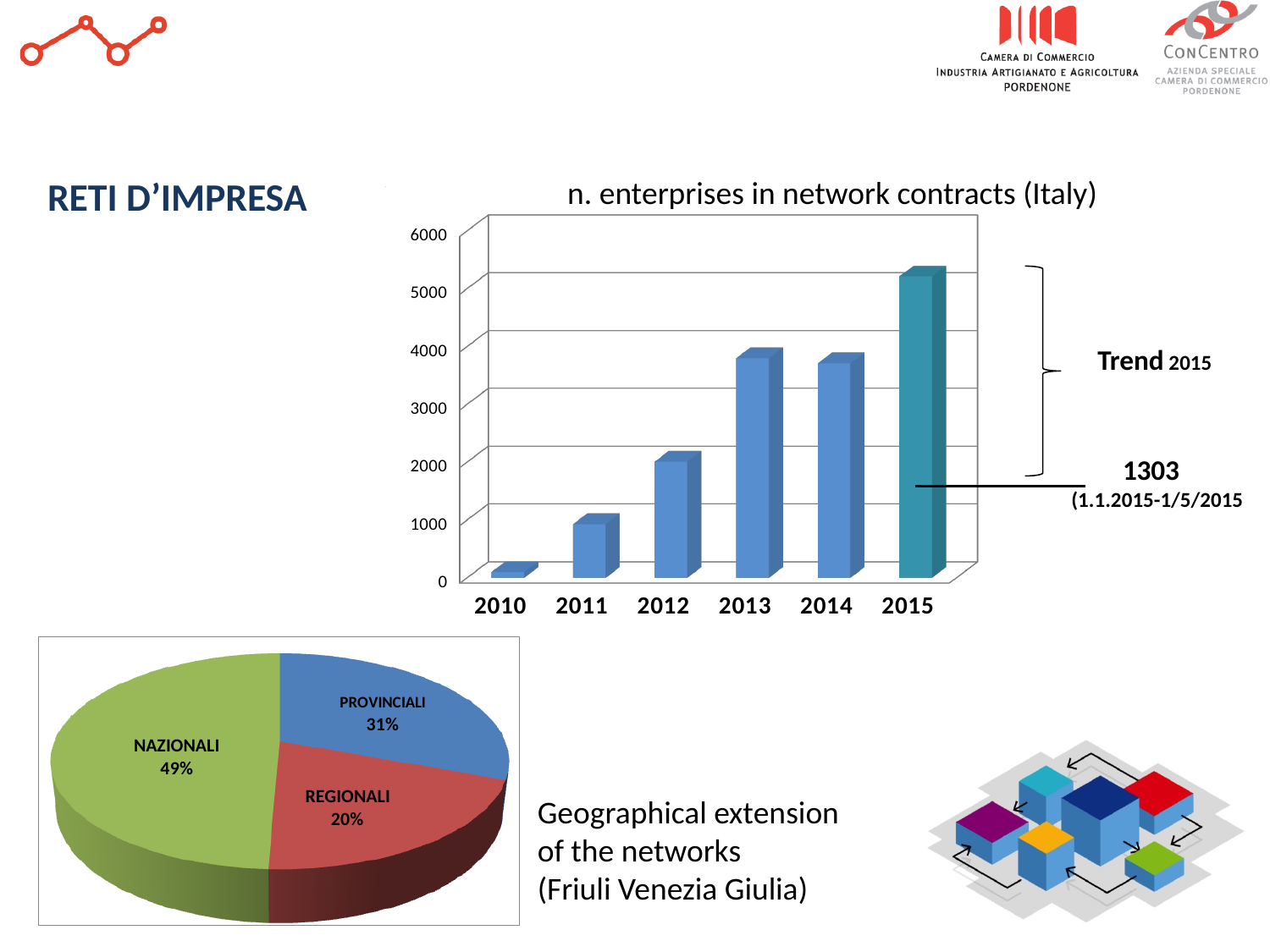
In the chart titled 'n. enterprises in network contracts (Italy)', what kind of chart is used? bar chart In the chart titled 'n. enterprises in network contracts (Italy)', is the value for 2010 greater or less than 1000? less In the pie chart at the bottom left, what share is NAZIONALI? 49% In the pie chart at the bottom left, what is the difference between the PROVINCIALI and REGIONALI shares? 11% In the chart titled 'n. enterprises in network contracts (Italy)', how many years are shown on the x axis? 6 In the chart titled 'n. enterprises in network contracts (Italy)', is the value for 2015 greater or less than 5000? greater In the chart titled 'n. enterprises in network contracts (Italy)', do the values generally rise or fall from 2010 to 2015? rise In the chart titled 'n. enterprises in network contracts (Italy)', which is larger, the value for 2014 or the value for 2015? 2015 In the pie chart at the bottom left, what share is REGIONALI? 20% In the chart titled 'n. enterprises in network contracts (Italy)', which year has the highest bar? 2015 In the chart titled 'n. enterprises in network contracts (Italy)', is the value for 2013 greater or less than 3000? greater In the chart titled 'n. enterprises in network contracts (Italy)', which year has the lowest bar? 2010